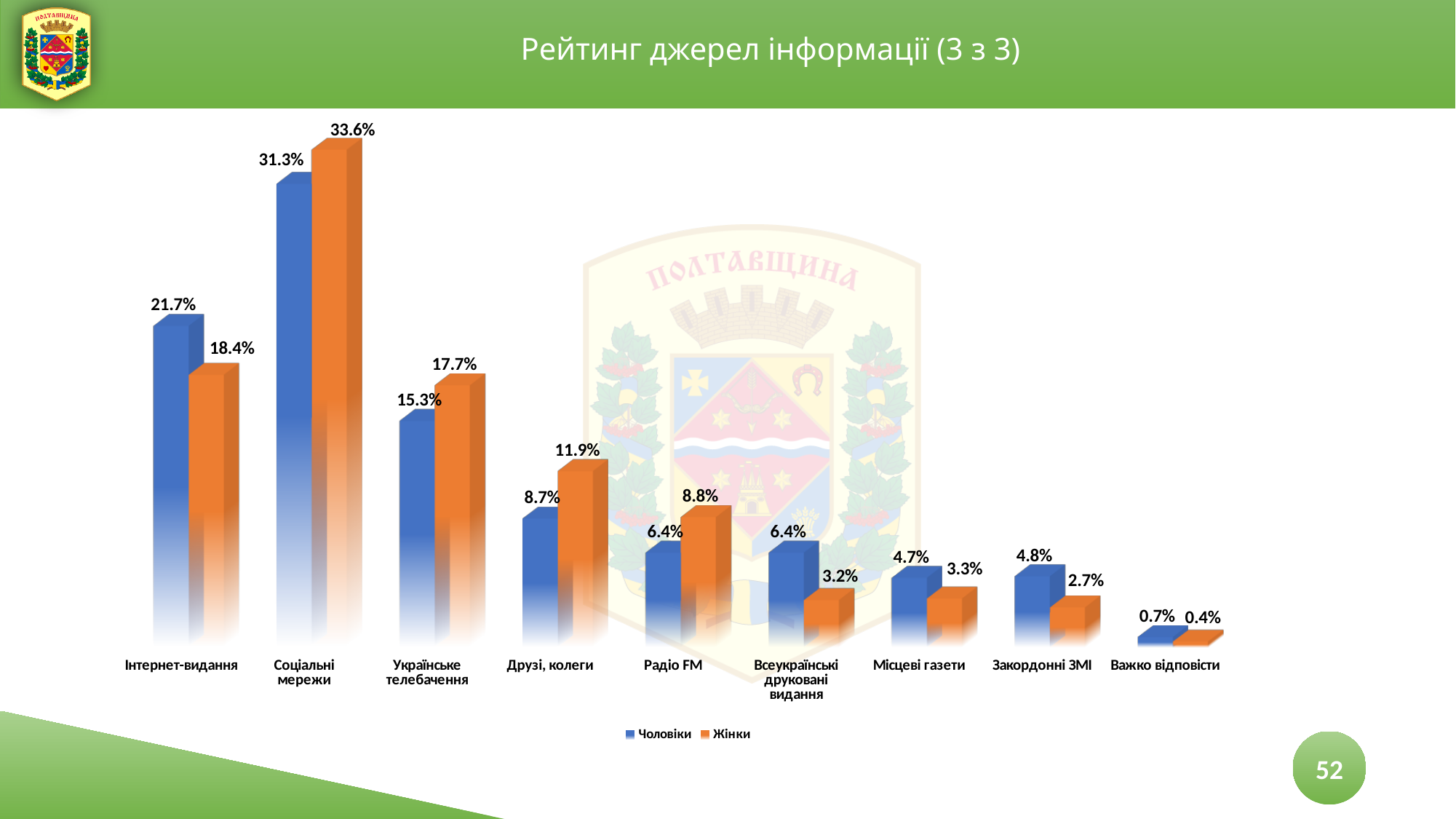
What is the difference between the Жінки and Чоловіки values for Українське телебачення? 2.4% Which category has the lowest value for Чоловіки? Важко відповісти Which is larger for Радіо FM: the value for Чоловіки or for Жінки? Жінки What is the value for Чоловіки in the Соціальні мережі category? 31.3% How many categories are shown on the x axis of the chart? 9 What is the value for Жінки in the Інтернет-видання category? 18.4% What type of chart is shown on the slide? Bar chart Which is larger for Закордонні ЗМІ: the value for Чоловіки or for Жінки? Чоловіки Which category has the highest value for Жінки? Соціальні мережи What is the difference between the Чоловіки and Жінки values for Всеукраїнські друковані видання? 3.2% What is the value for Жінки in the Друзі, колеги category? 11.9% How many series does the legend list? 2